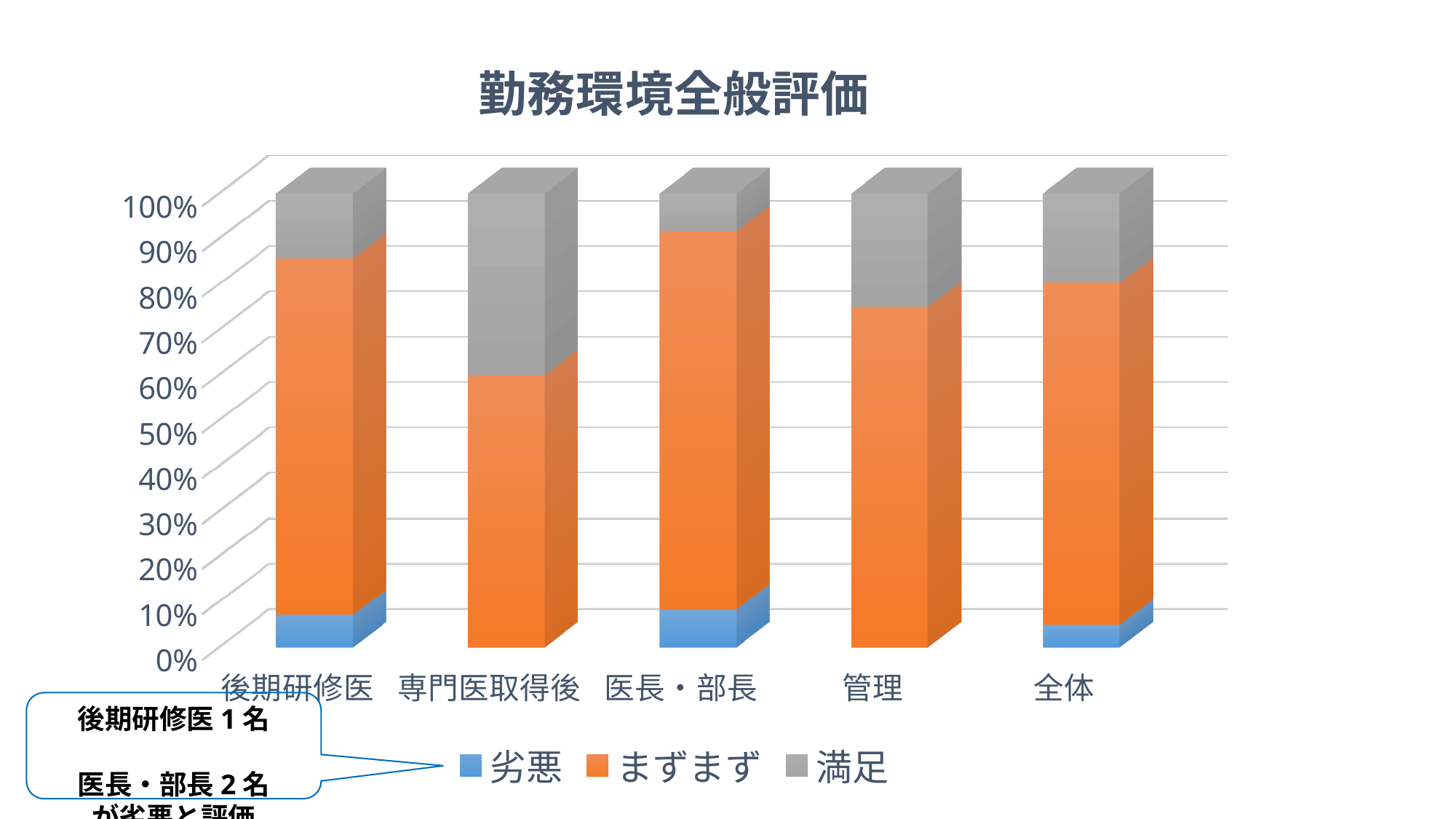
Is the まずまず share for 専門医取得後 greater or less than 70%? less Is the 劣悪 share for 後期研修医 greater or less than 20%? less Which series is shown in orange in the legend? まずまず What is the title of the chart? 勤務環境全般評価 Is the 満足 share larger for 専門医取得後 or for 管理? 専門医取得後 Is the まずまず share for 医長・部長 greater or less than 70%? greater Which category has the largest 満足 share? 専門医取得後 How many series does the legend list? 3 What kind of chart is shown on the slide? stacked bar chart How many categories are shown on the x axis of the chart? 5 Is the 劣悪 share larger for 医長・部長 or for 管理? 医長・部長 How many categories show no 劣悪 segment at all? 2